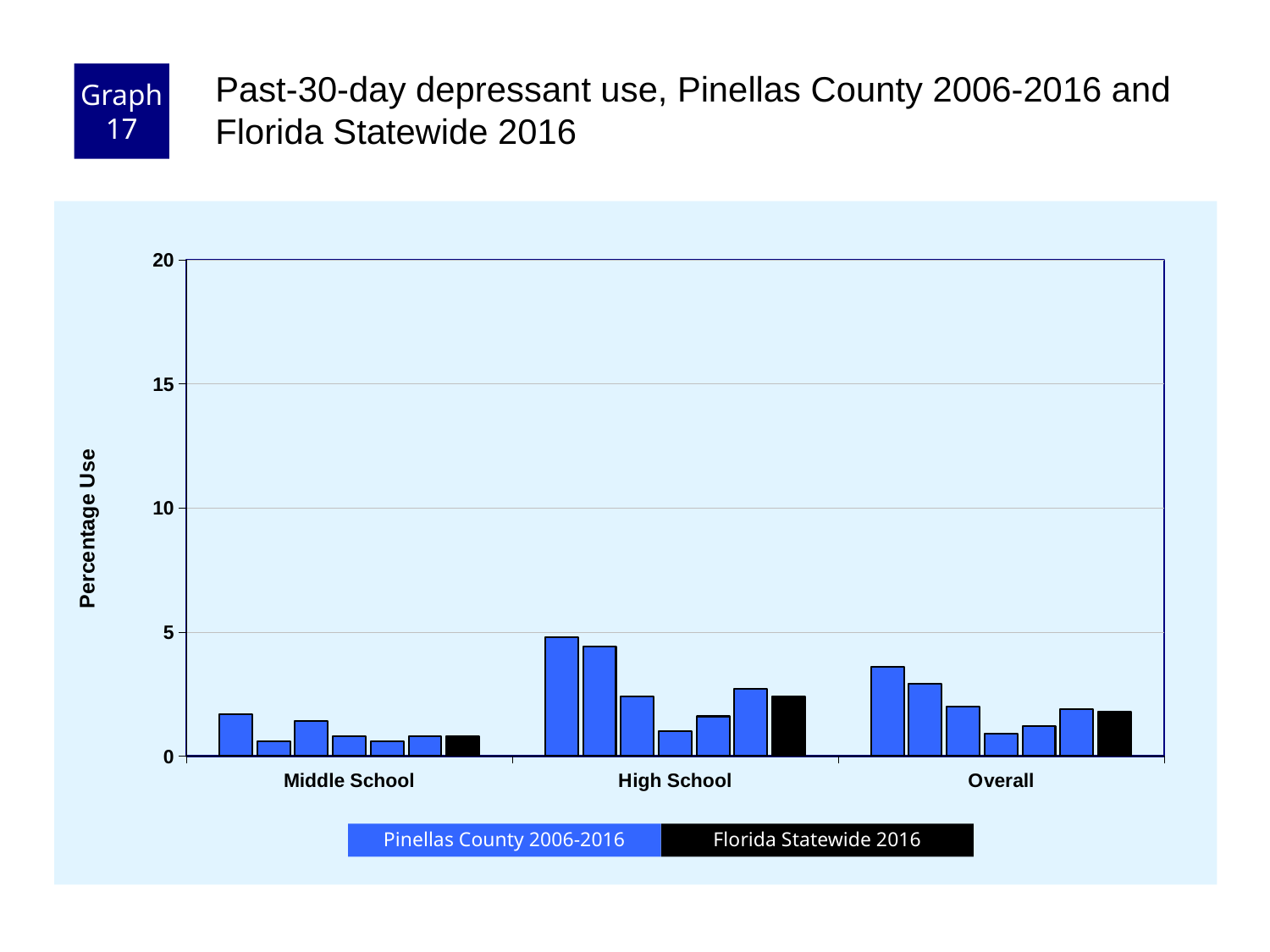
Which category group contains the tallest bar on the chart? High School What kind of chart is shown on the slide? bar chart How many categories are shown on the x axis? 3 Is the Florida Statewide 2016 value for Middle School greater or less than 5? less What is the label on the y axis? Percentage Use Which is larger, the Florida Statewide 2016 value for High School or for Middle School? High School How many bars are plotted in the High School group? 7 How many series does the legend list? 2 Which is larger, the Florida Statewide 2016 value for Overall or for Middle School? Overall Is the Florida Statewide 2016 value for High School greater or less than 5? less Is the tallest Pinellas County bar in the High School group greater or less than 10? less Which category has the lowest Florida Statewide 2016 bar? Middle School